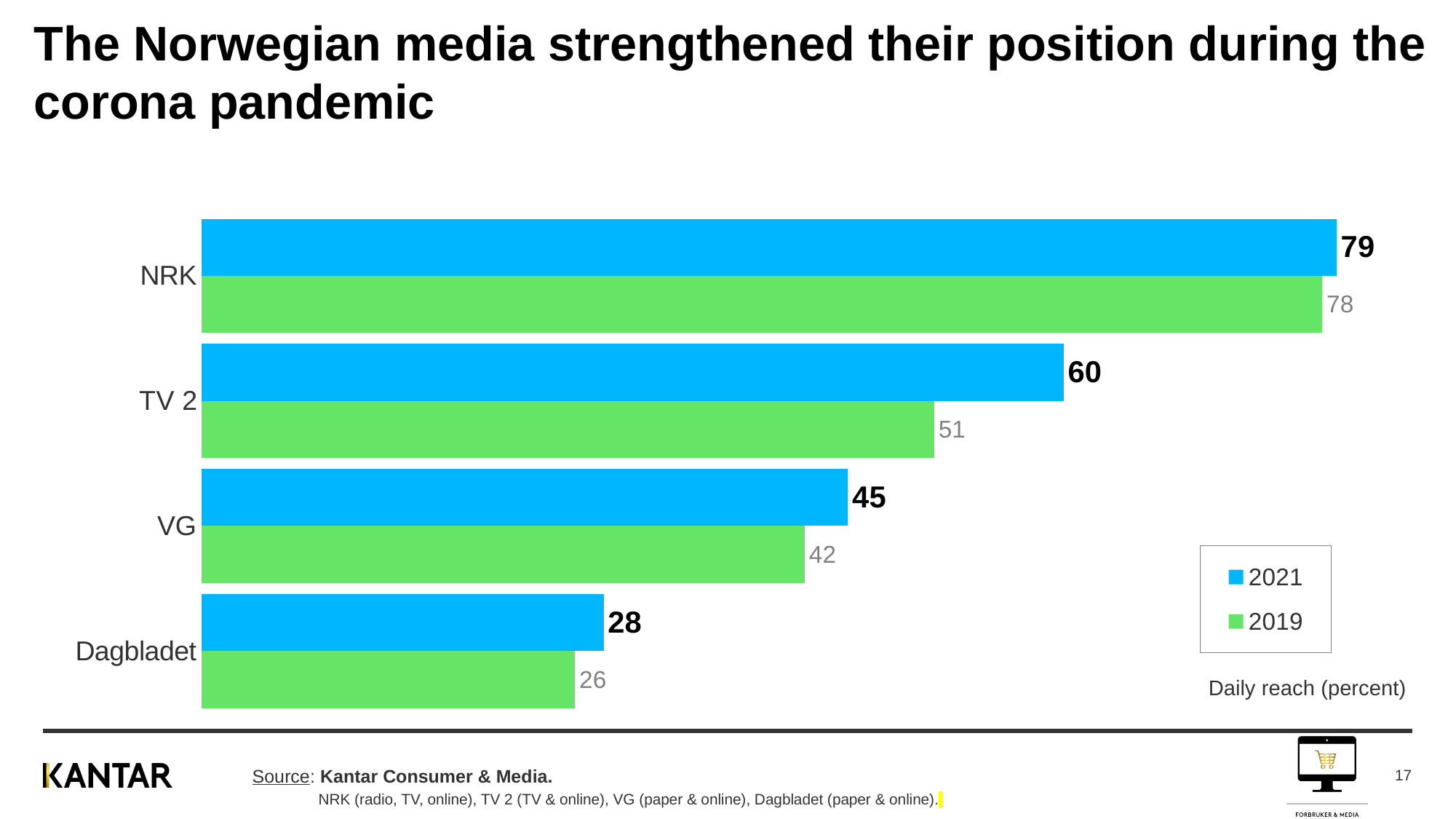
What is the 2021 daily reach value for NRK? 79 What is the difference between TV 2's 2021 and 2019 daily reach values? 9 Which media outlet has the lowest 2019 daily reach? Dagbladet How many series does the legend list? 2 Which media outlet has the highest 2021 daily reach? NRK Which year is represented by the green bars? 2019 How many media outlets are shown in the chart? 4 What is the 2019 daily reach value for TV 2? 51 What is the 2021 daily reach value for Dagbladet? 28 What type of chart is shown on the slide? Bar chart Which is larger: VG's 2021 value or TV 2's 2019 value? TV 2's 2019 value What is the 2019 daily reach value for VG? 42